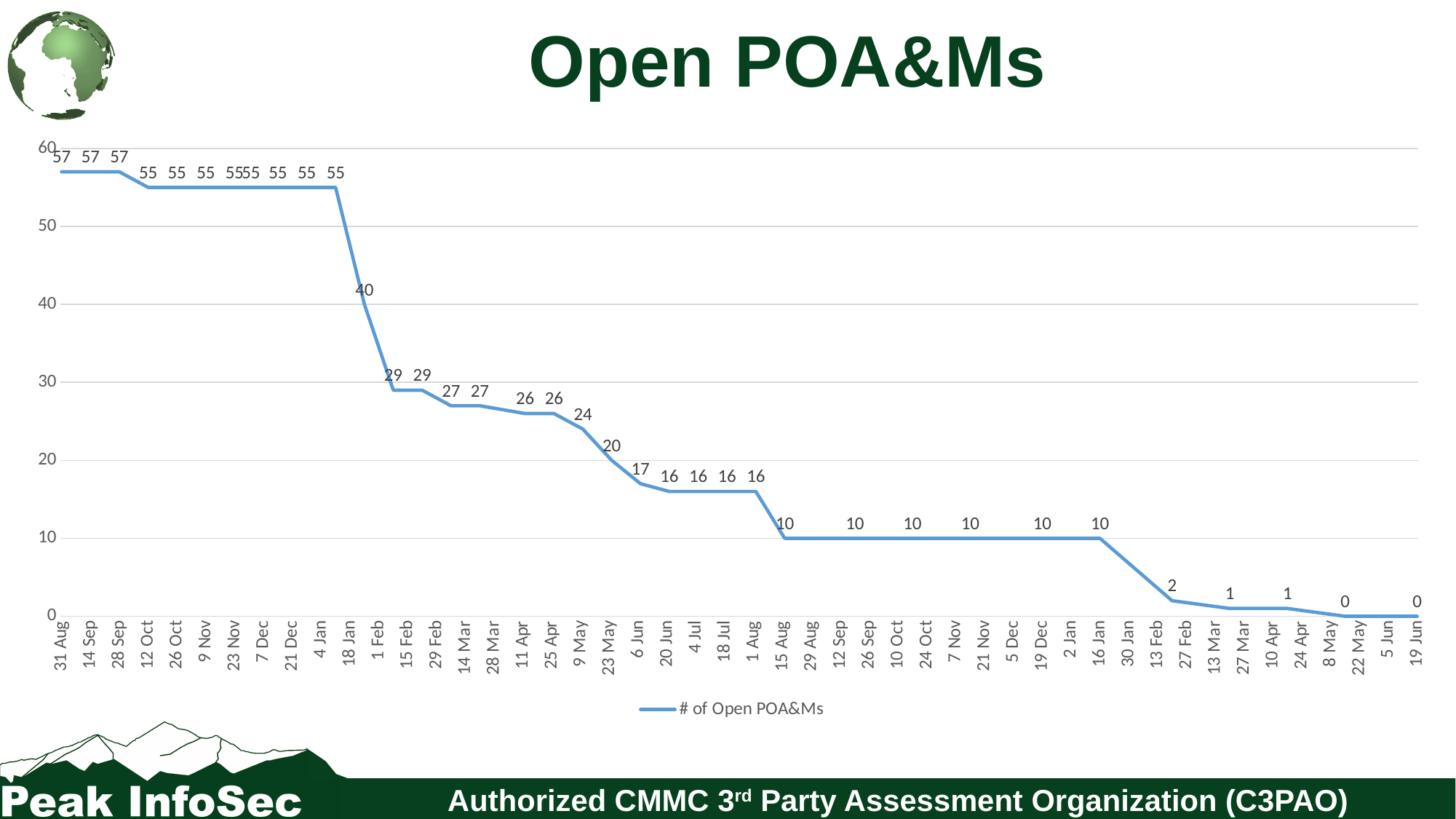
What is the number of open POA&Ms on 31 Aug? 57 Do the values generally rise or fall along the x axis? fall Is the value on 15 Aug greater or less than 20? less What is the number of open POA&Ms on 6 Jun? 17 What type of chart is shown on the slide? line chart What is the highest value plotted on the chart? 57 What is the title of the chart? Open POA&Ms What is the lowest value plotted on the chart? 0 What is the number of open POA&Ms on 23 May? 20 How many series does the legend list? 1